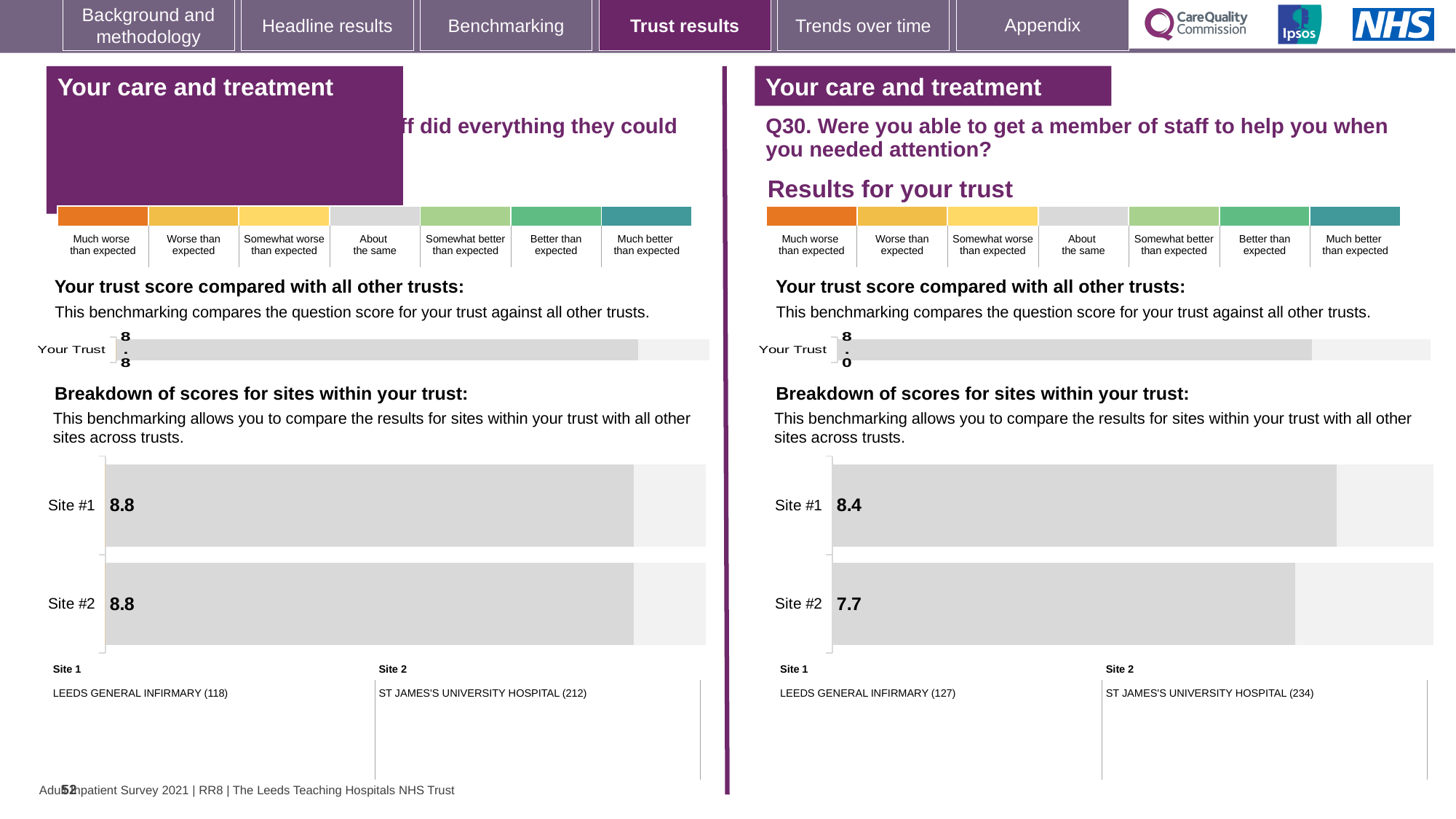
On the left-hand panel, what is the score for Site #2 in the breakdown of scores for sites within your trust? 8.8 On the right-hand panel (Q30), what is the score shown for Your Trust in the trust score chart? 8.0 On the right-hand panel (Q30), which site has the lowest score in the site breakdown chart? Site #2 On the right-hand panel (Q30), what is the score for Site #1 in the breakdown of scores for sites within your trust? 8.4 What type of chart is used for the breakdown of scores for sites on the left-hand panel? Bar chart On the left-hand panel, what is the score for Site #1 in the breakdown of scores for sites within your trust? 8.8 On the right-hand panel (Q30), which site has the higher score in the site breakdown chart? Site #1 How many sites are shown in the site breakdown chart on the right-hand panel (Q30)? 2 On the right-hand panel (Q30), what is the score for Site #2 in the breakdown of scores for sites within your trust? 7.7 On the right-hand panel (Q30), is the Site #2 score larger or smaller than the Site #1 score? Smaller On the right-hand panel (Q30), what is the difference between the Site #1 and Site #2 scores? 0.7 On the left-hand panel, what is the score shown for Your Trust in the trust score chart? 8.8